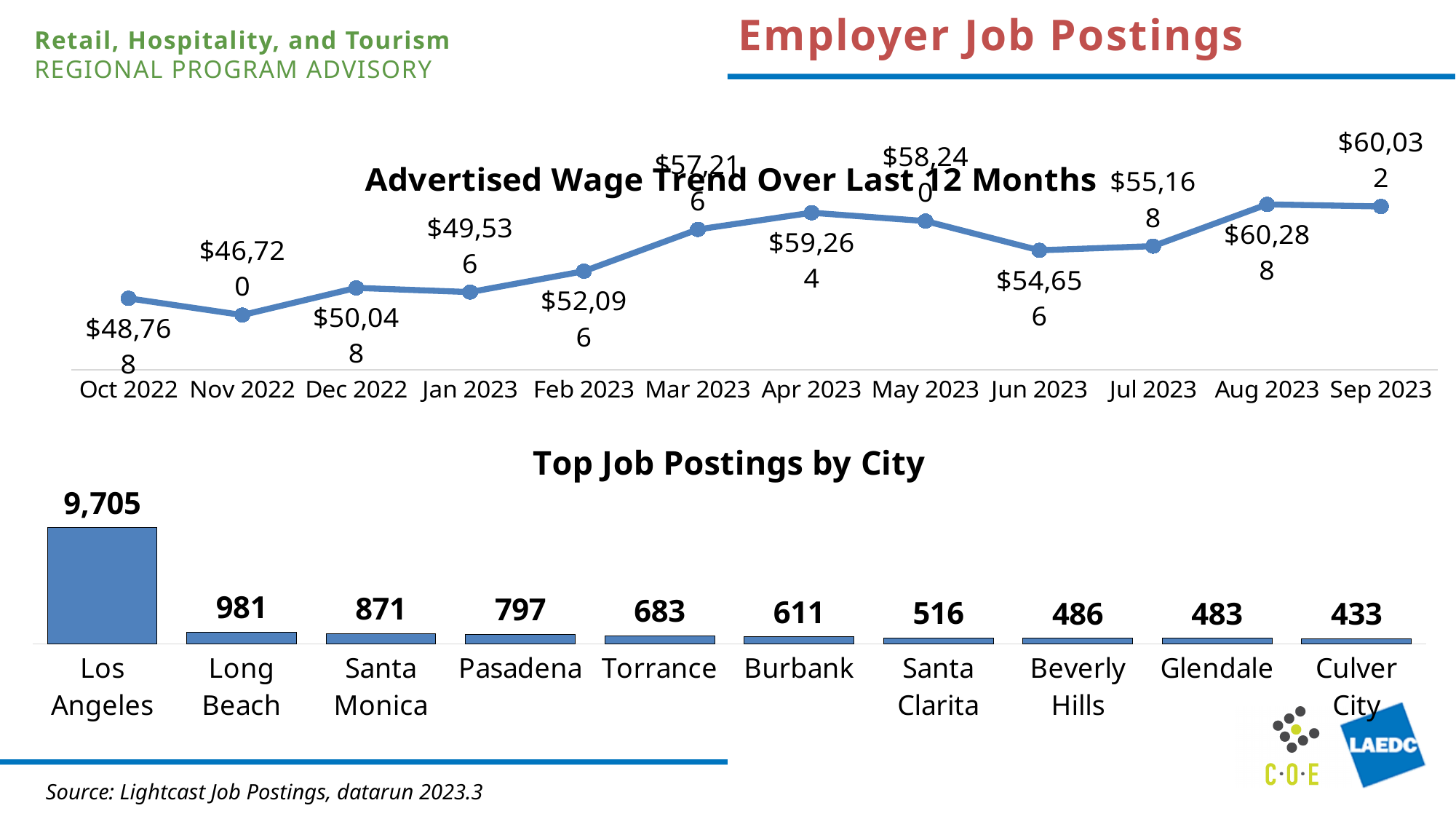
In the 'Top Job Postings by City' chart, how many job postings does Burbank have? 611 In the 'Advertised Wage Trend Over Last 12 Months' chart, what is the advertised wage for Aug 2023? $60,288 In the 'Top Job Postings by City' chart, how many cities are shown? 10 In the 'Top Job Postings by City' chart, how many job postings does Los Angeles have? 9,705 In the 'Advertised Wage Trend Over Last 12 Months' chart, is the advertised wage higher in Mar 2023 or Jun 2023? Mar 2023 What type of chart is 'Advertised Wage Trend Over Last 12 Months'? Line chart In the 'Advertised Wage Trend Over Last 12 Months' chart, which month has the lowest advertised wage? Nov 2022 In the 'Top Job Postings by City' chart, which city has the fewest job postings? Culver City In the 'Advertised Wage Trend Over Last 12 Months' chart, what is the advertised wage for Nov 2022? $46,720 In the 'Advertised Wage Trend Over Last 12 Months' chart, how many months are plotted? 12 In the 'Top Job Postings by City' chart, what is the difference in job postings between Long Beach and Santa Monica? 110 What type of chart is 'Top Job Postings by City'? Bar chart